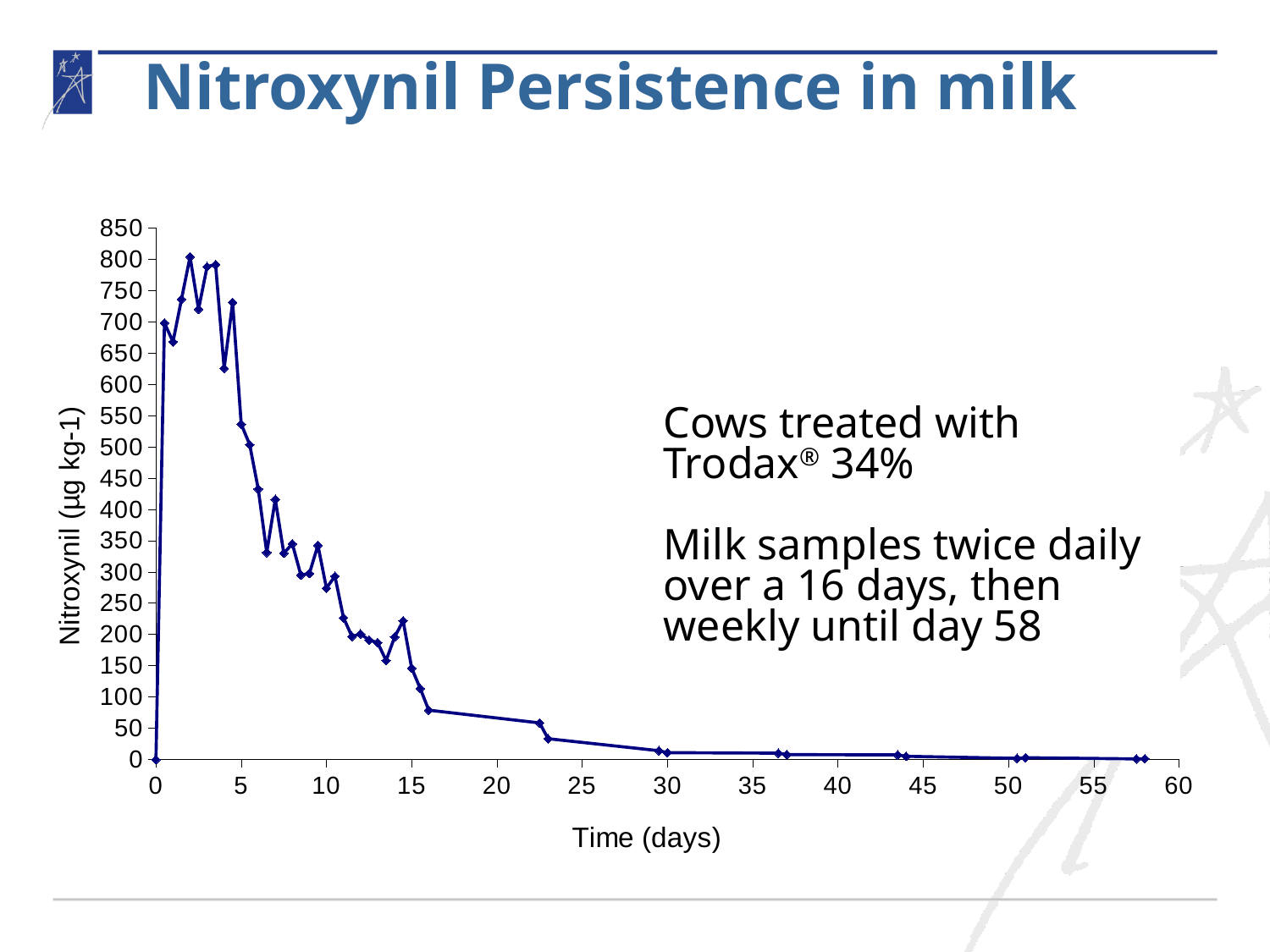
Is the nitroxynil value at day 30 greater or less than 50? less What is the label of the x axis? Time (days) What is the title of the slide containing the chart? Nitroxynil Persistence in milk Is the nitroxynil value at day 23 larger or smaller than the value at day 16? smaller Is the nitroxynil value at day 0 greater or less than 50? less Is the nitroxynil value at day 5 greater or less than 600? less What kind of chart is shown on the slide? line chart Is the nitroxynil value at day 2 larger or smaller than the value at day 10? larger Do the nitroxynil values generally rise or fall between day 5 and day 30? fall